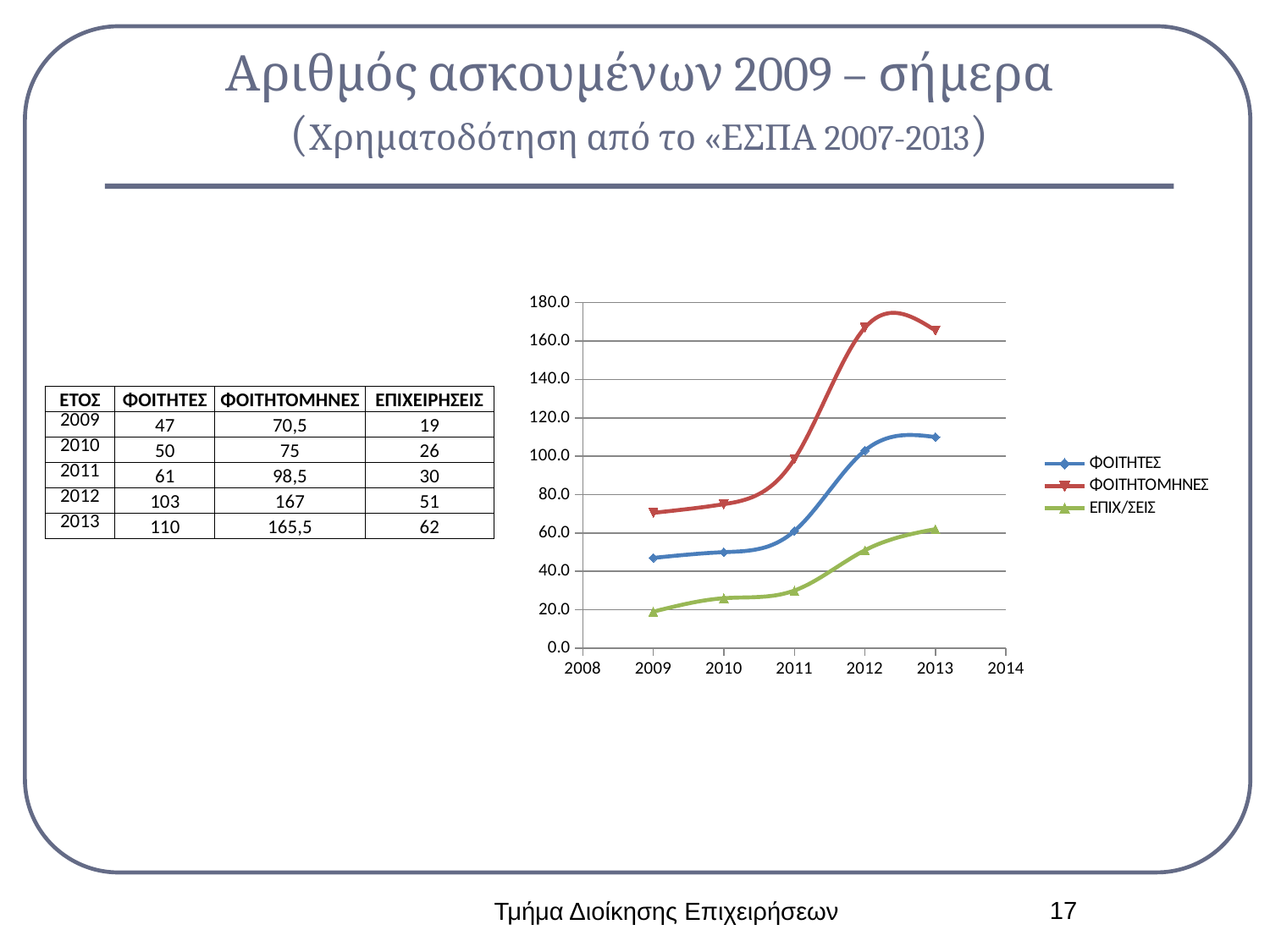
Is the value for ΦΟΙΤΗΤΕΣ in 2011 greater or less than 80? less How many data points does each line in the chart have? 5 Is the value for ΕΠΙΧ/ΣΕΙΣ in 2009 greater or less than 40? less Which series has the lowest values in the chart? ΕΠΙΧ/ΣΕΙΣ Which series has the highest values in the chart? ΦΟΙΤΗΤΟΜΗΝΕΣ According to the table on the slide, what is the value for ΦΟΙΤΗΤΟΜΗΝΕΣ in 2012? 167 Is the value for ΦΟΙΤΗΤΟΜΗΝΕΣ in 2012 greater or less than 160? greater Which is larger in 2013, the value for ΦΟΙΤΗΤΕΣ or the value for ΕΠΙΧ/ΣΕΙΣ? ΦΟΙΤΗΤΕΣ What colour is the ΦΟΙΤΗΤΟΜΗΝΕΣ line in the chart? red What kind of chart is shown on the slide? line chart Does the ΦΟΙΤΗΤΕΣ line rise or fall from 2009 to 2013? rise How many series does the chart legend list? 3